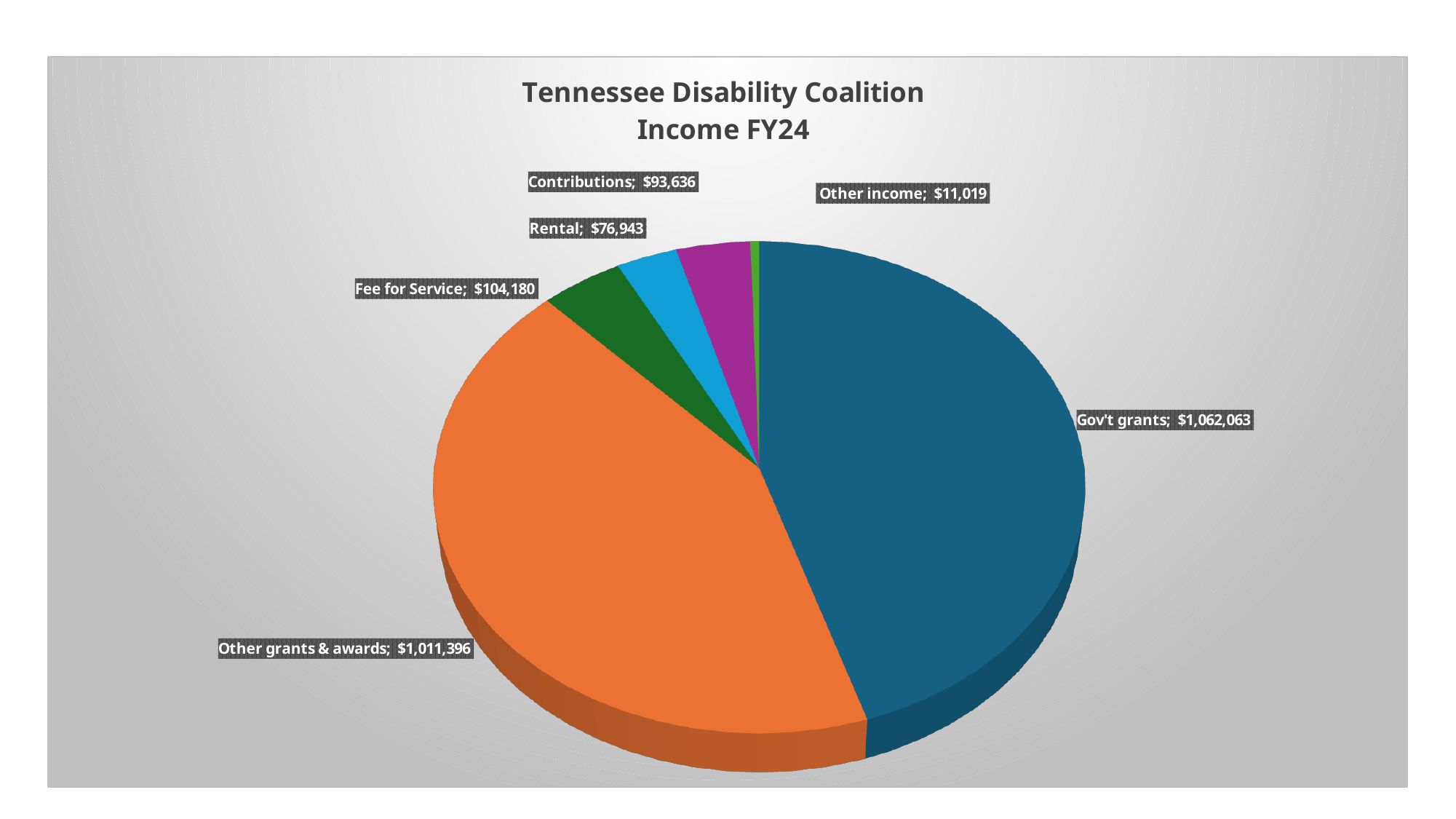
What is the value for Rental? $76,943 What is the title of the chart? Tennessee Disability Coalition Income FY24 What is the value for Other grants & awards? $1,011,396 What is the difference between Contributions and Rental? $16,693 Which is larger, Fee for Service or Contributions? Fee for Service Which income category has the smallest value? Other income What is the value for Fee for Service? $104,180 What type of chart is shown on the slide? Pie chart What is the value for Gov't grants? $1,062,063 What is the difference between Gov't grants and Other grants & awards? $50,667 Which income category has the largest value? Gov't grants How many income categories are shown in the pie chart? 6